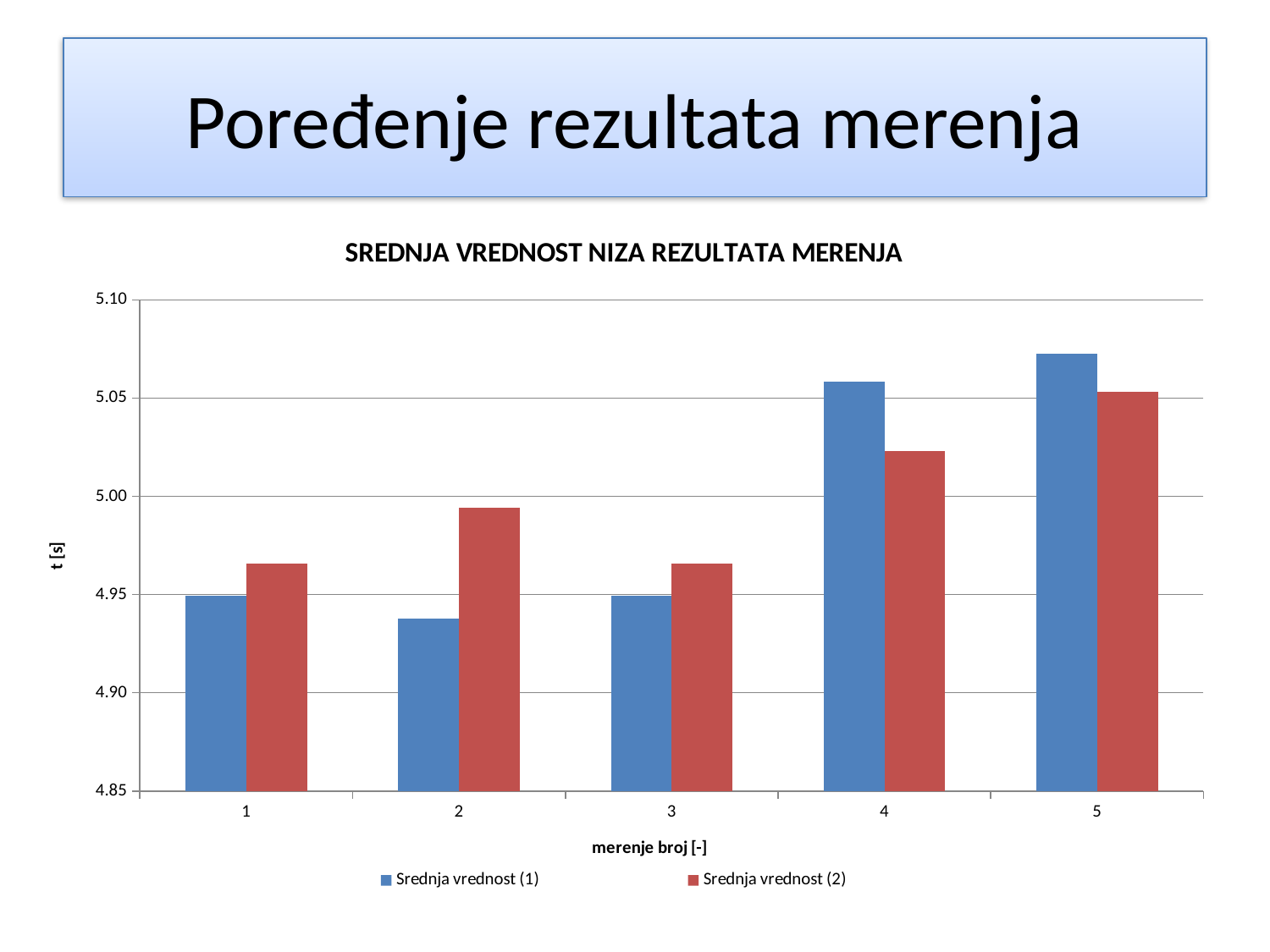
How many series does the legend list? 2 What is the label of the y axis? t [s] For measurement number 4, which series has the larger value, Srednja vrednost (1) or Srednja vrednost (2)? Srednja vrednost (1) Is the value of Srednja vrednost (2) for measurement number 2 greater or less than 5.00? less For which measurement number is the value of Srednja vrednost (2) highest? 5 For which measurement number is the value of Srednja vrednost (1) lowest? 2 What kind of chart is shown on the slide? bar chart For which measurement number is the value of Srednja vrednost (1) highest? 5 For measurement number 2, which series has the larger value, Srednja vrednost (1) or Srednja vrednost (2)? Srednja vrednost (2) How many measurement numbers (categories) are shown on the x axis? 5 What is the title of the chart? SREDNJA VREDNOST NIZA REZULTATA MERENJA Is the value of Srednja vrednost (1) for measurement number 5 greater or less than 5.05? greater